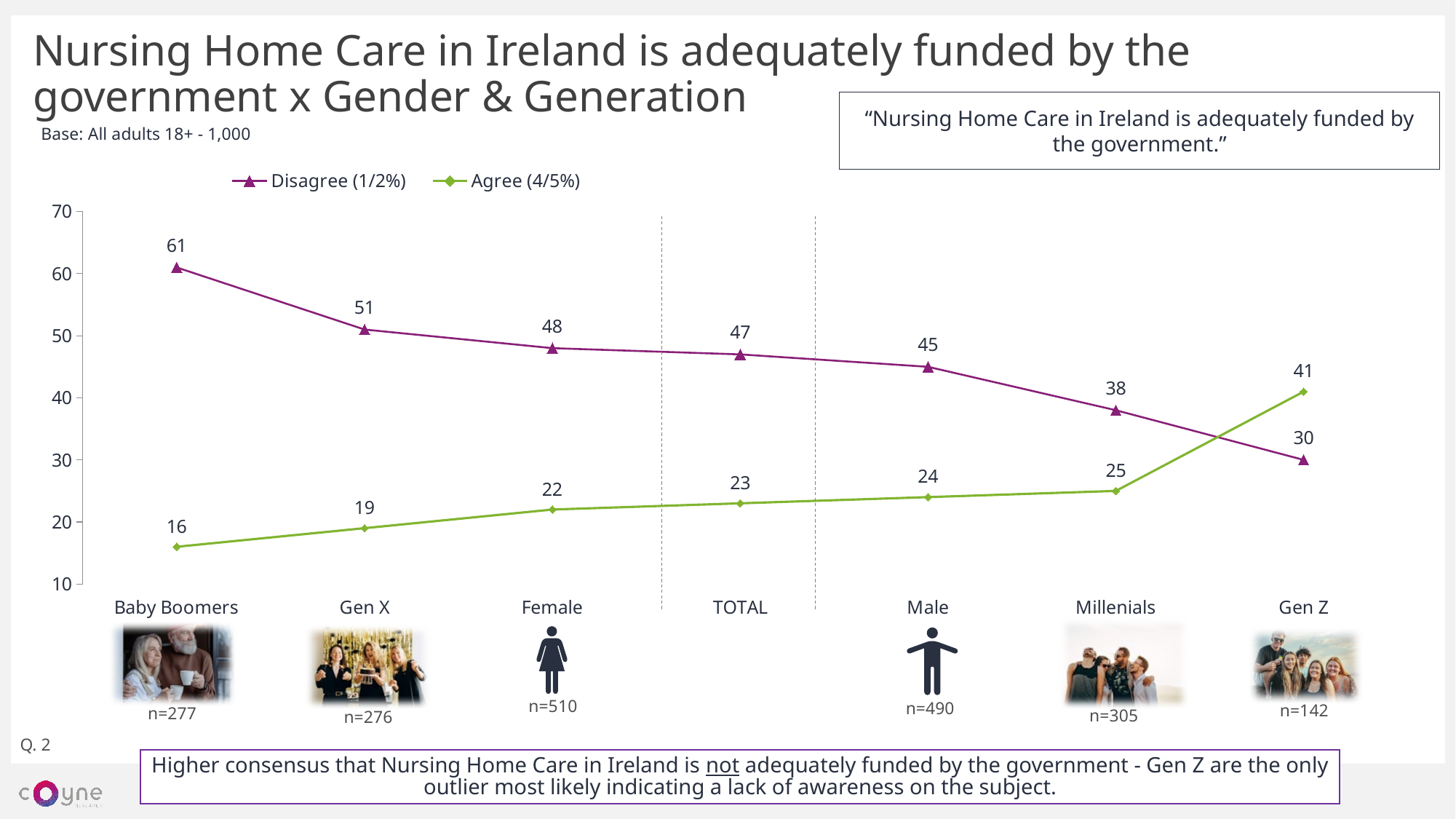
Which category has the lowest Agree (4/5%) value? Baby Boomers What is the Agree (4/5%) value for Millenials? 25 What is the difference between the Disagree (1/2%) and Agree (4/5%) values for Male? 21 Which is larger for Gen Z: the Disagree (1/2%) value or the Agree (4/5%) value? Agree (4/5%) How many categories are shown on the x axis? 7 What is the Disagree (1/2%) value for Baby Boomers? 61 What kind of chart is shown on the slide? Line chart Does the Agree (4/5%) series rise or fall from Baby Boomers to Gen Z? Rise What is the Agree (4/5%) value for Gen Z? 41 What is the Disagree (1/2%) value for TOTAL? 47 How many series does the legend list? 2 Which category has the highest Disagree (1/2%) value? Baby Boomers